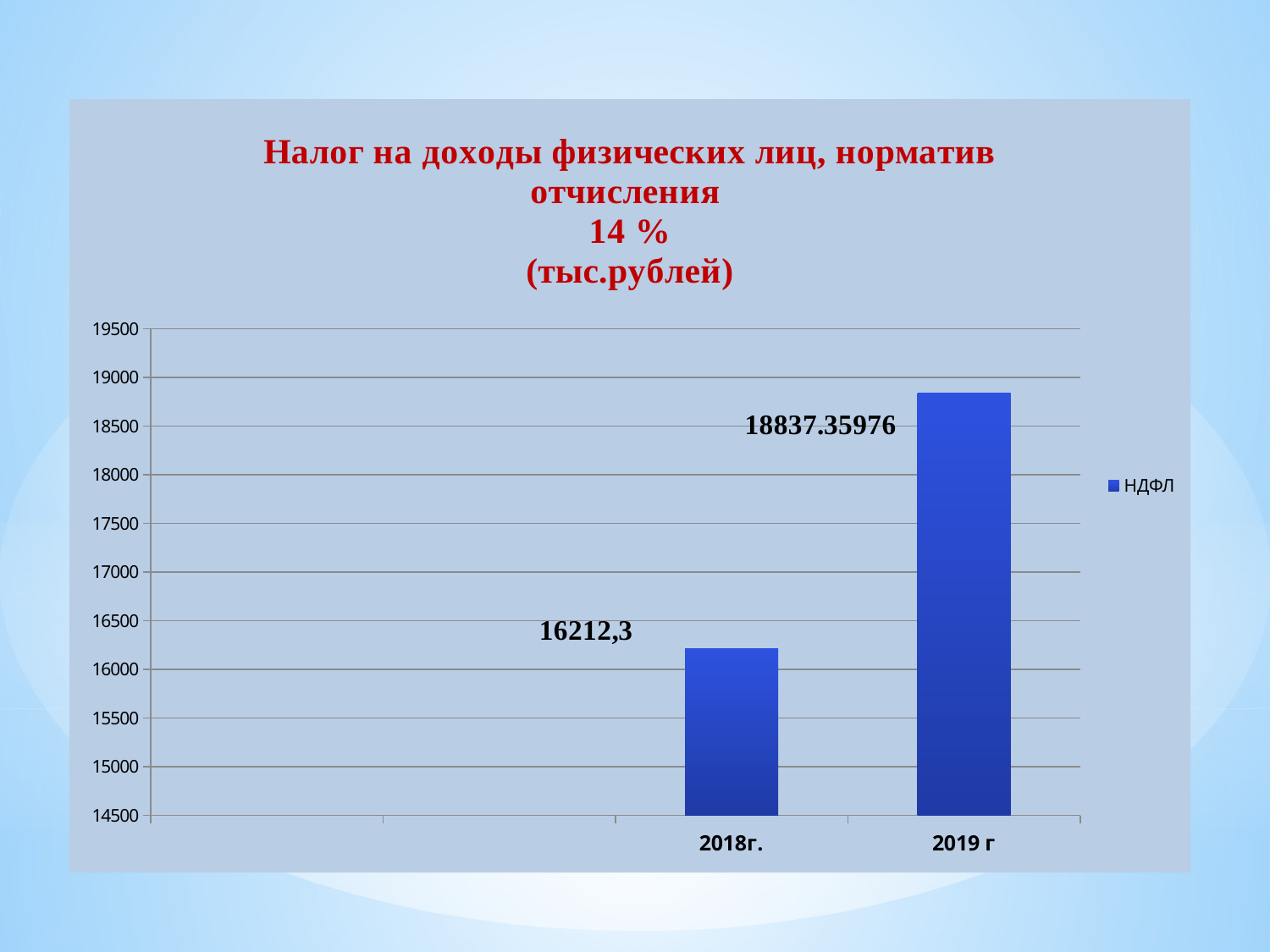
What is the difference between the values for 2019 г and 2018г.? 2625.05976 Is the value for 2018г. greater or less than 16000? greater What series name is shown in the legend? НДФЛ How many series does the legend list? 1 Is the value for 2019 г greater or less than 19000? less Which year has the lowest value? 2018г. Which is larger, the value for 2018г. or the value for 2019 г? 2019 г Which year has the highest value? 2019 г What kind of chart is shown on the slide? bar chart What is the value for 2019 г? 18837.35976 How many categories are shown on the x axis? 2 What is the value for 2018г.? 16212,3